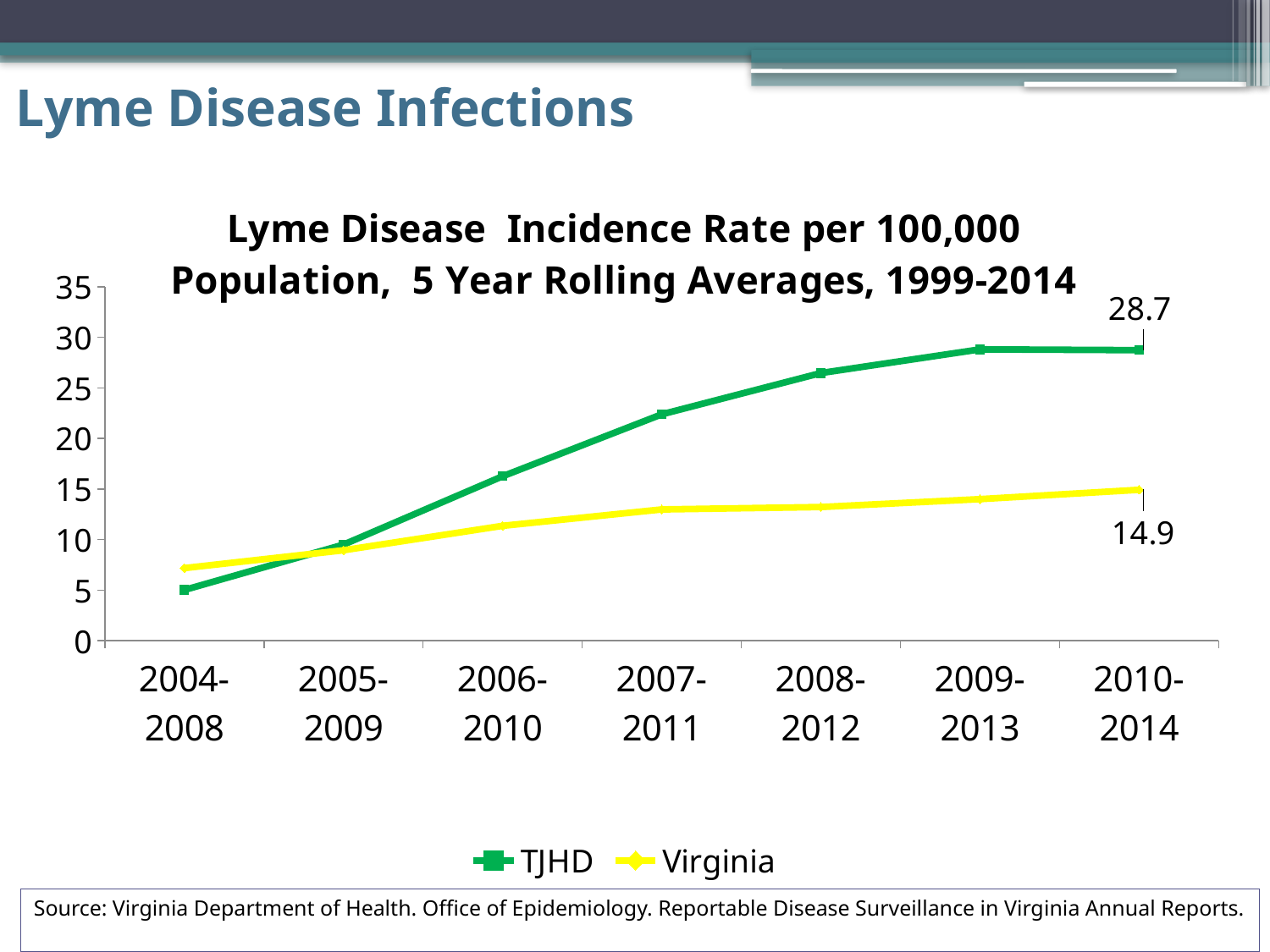
Is the TJHD value for 2007-2011 greater or less than 20? greater How many periods are shown on the x axis? 7 Which series has the higher value for 2004-2008, TJHD or Virginia? Virginia What is the TJHD value for 2010-2014? 28.7 Does the TJHD series rise or fall from 2004-2008 to 2009-2013? rise Is the Virginia value for 2004-2008 greater or less than 10? less Is the TJHD value for 2004-2008 greater or less than 10? less What is the difference between the TJHD and Virginia values for 2010-2014? 13.8 How many series does the legend list? 2 What kind of chart is shown? line chart What is the Virginia value for 2010-2014? 14.9 Which series has the higher value for 2010-2014, TJHD or Virginia? TJHD